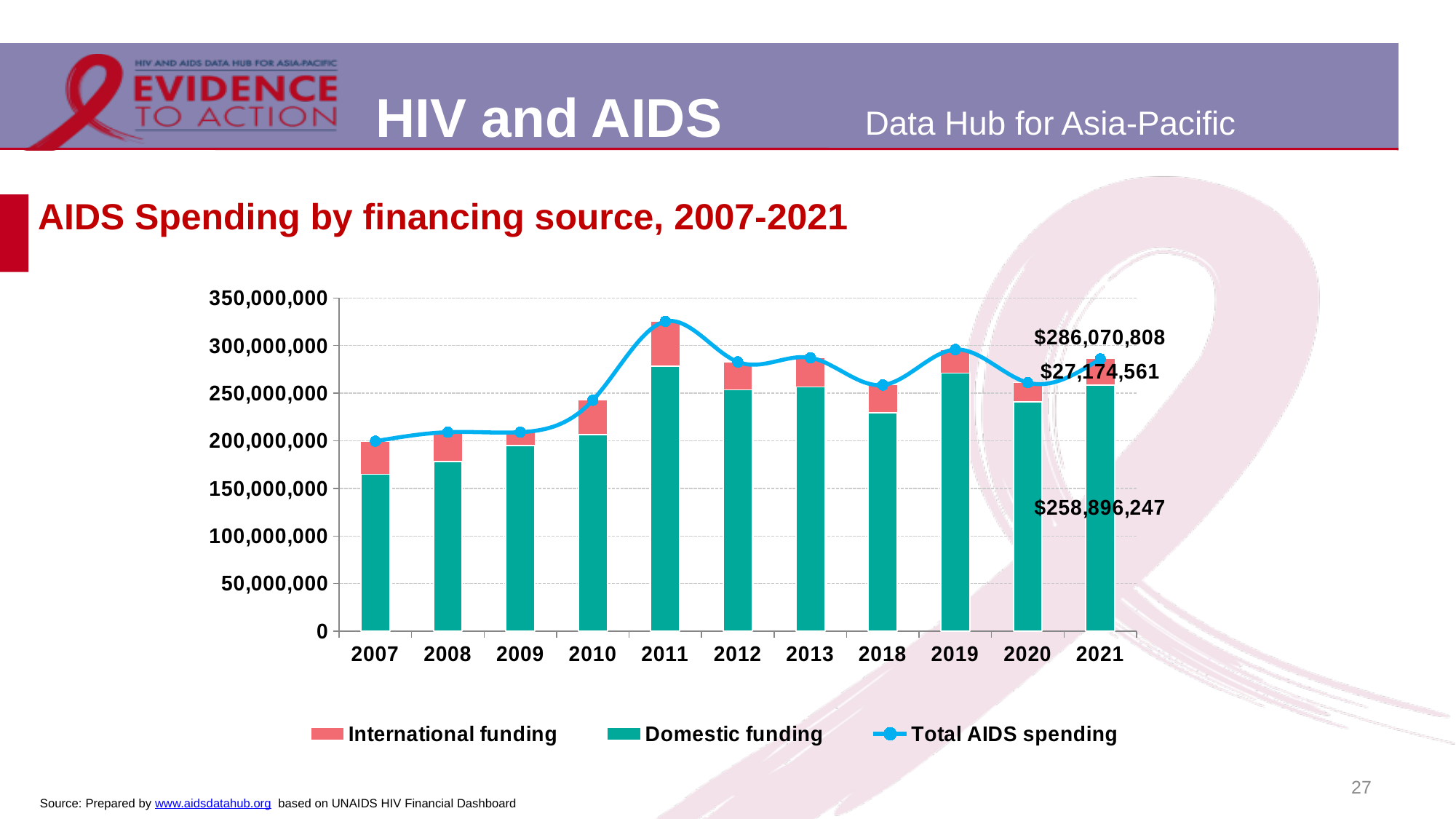
What is the Total AIDS spending value labelled for 2021? $286,070,808 What is the International funding value labelled for 2021? $27,174,561 Is the Domestic funding for 2018 greater or less than 250,000,000? less Which year has larger Domestic funding, 2018 or 2019? 2019 How many series does the legend list? 3 What kind of chart is shown on the slide? bar chart with a line In which year is Domestic funding lowest? 2007 Is the Total AIDS spending for 2011 greater or less than 300,000,000? greater In which year is Total AIDS spending highest? 2011 What is the Domestic funding value labelled for 2021? $258,896,247 Does Total AIDS spending rise or fall from 2007 to 2011? rise How many years are shown on the x axis of the chart? 11